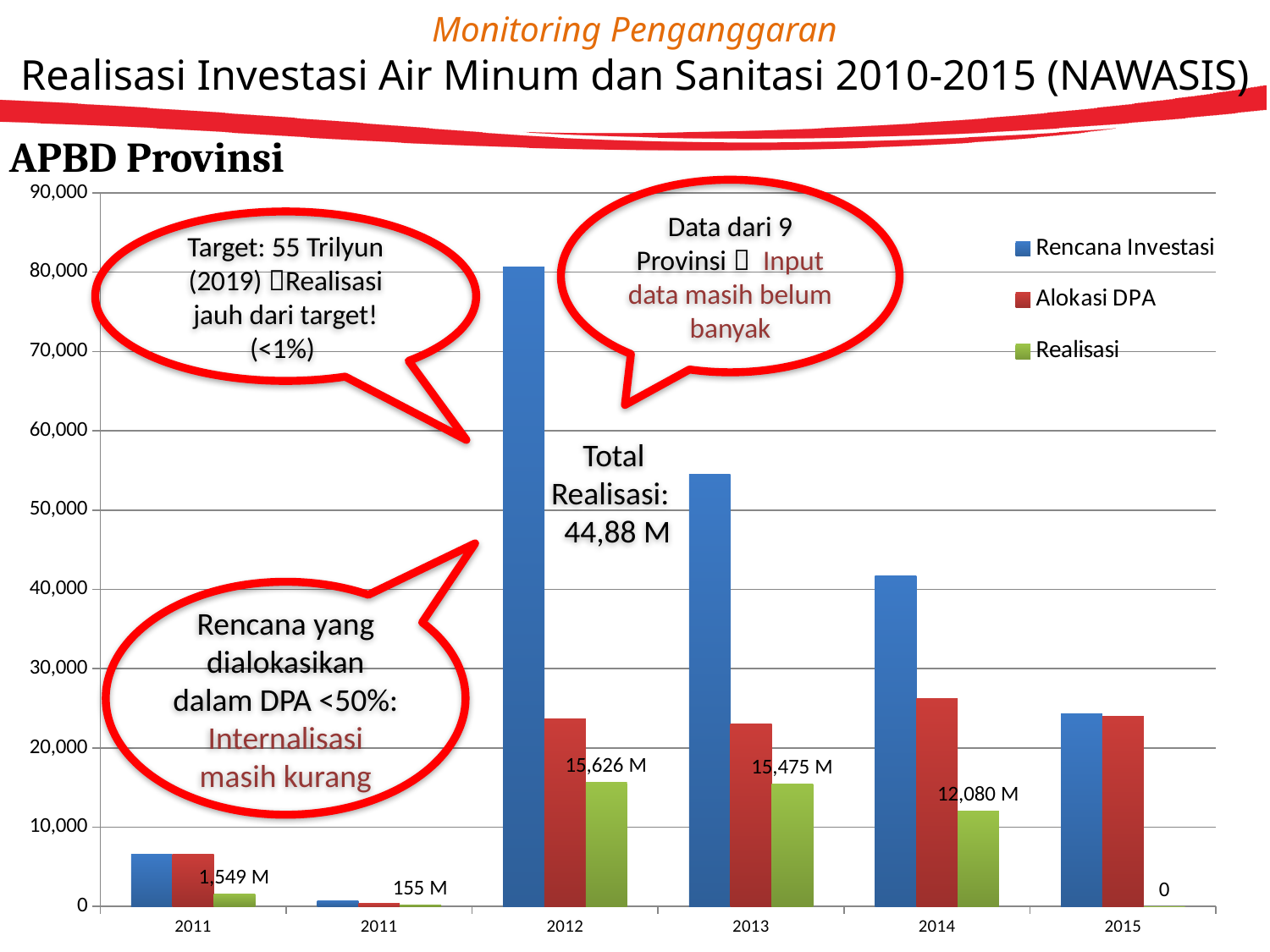
What kind of chart is shown on the slide? bar chart What is the Realisasi value for 2015? 0 How many series does the legend list? 3 Does the Rencana Investasi series rise or fall from 2012 to 2015? fall What is the Realisasi value for 2014? 12,080 M Which is larger, the Realisasi value for 2013 or for 2014? 2013 Which year has the highest Rencana Investasi bar? 2012 What is the difference between the Realisasi values for 2012 and 2013? 151 M Is the Rencana Investasi value for 2012 greater or less than 70,000? greater How many category groups are shown on the x axis? 6 Is the Rencana Investasi value for 2014 greater or less than 50,000? less What is the Realisasi value for 2012? 15,626 M